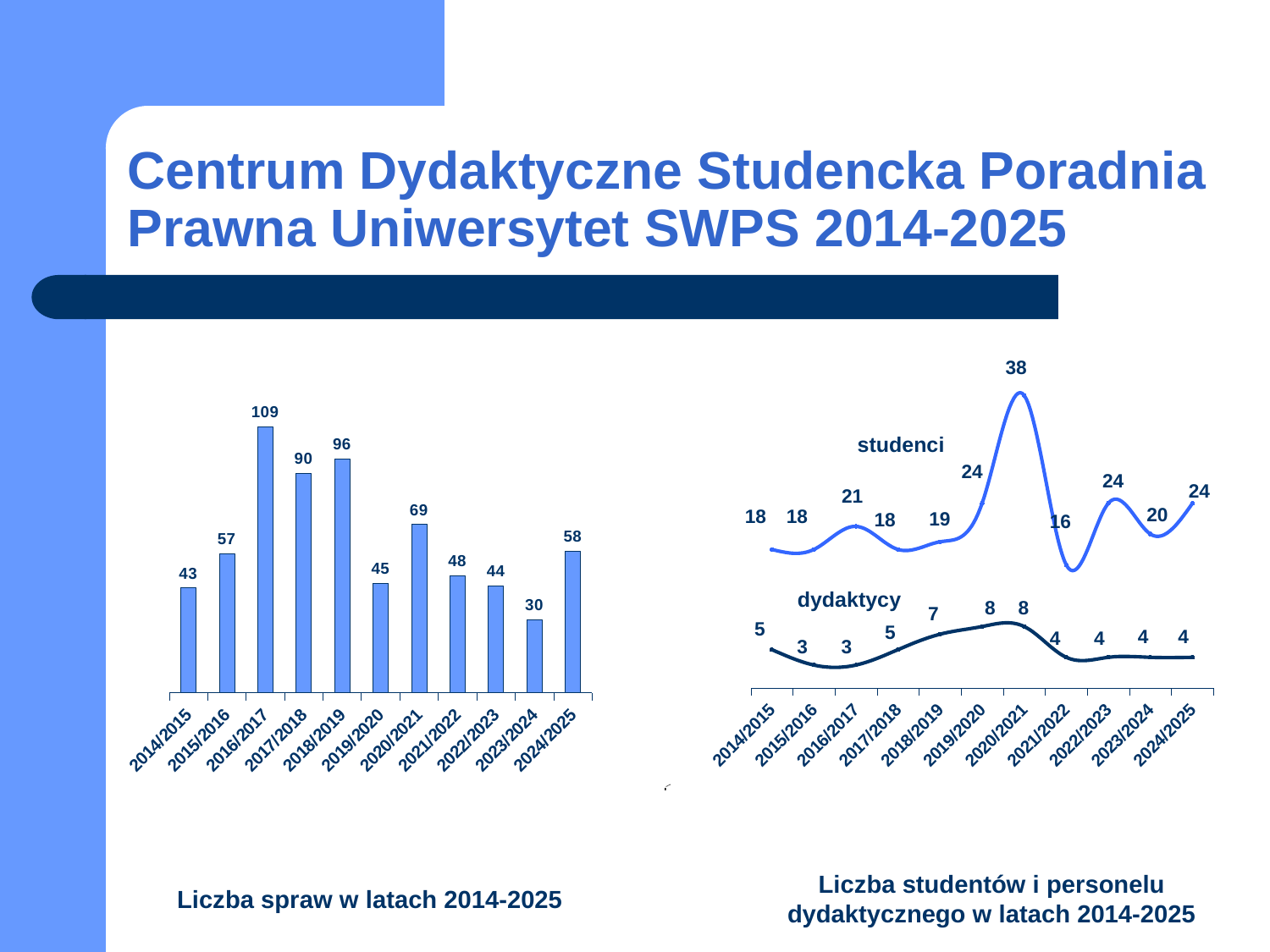
In the right chart (Liczba studentów i personelu dydaktycznego), what is the difference between studenci and dydaktycy in 2024/2025? 20 In the right chart (Liczba studentów i personelu dydaktycznego), what is the value for studenci in 2020/2021? 38 In the right chart (Liczba studentów i personelu dydaktycznego), what is the value for dydaktycy in 2018/2019? 7 In the left chart (Liczba spraw w latach 2014-2025), what is the difference between the values for 2018/2019 and 2017/2018? 6 In the left chart (Liczba spraw w latach 2014-2025), how many years are shown on the x axis? 11 In the right chart (Liczba studentów i personelu dydaktycznego), how many series are plotted? 2 What kind of chart is the left chart (Liczba spraw w latach 2014-2025)? bar chart In the right chart (Liczba studentów i personelu dydaktycznego), which series is higher in 2021/2022, studenci or dydaktycy? studenci What kind of chart is the right chart (Liczba studentów i personelu dydaktycznego)? line chart In the left chart (Liczba spraw w latach 2014-2025), which year has the lowest value? 2023/2024 In the left chart (Liczba spraw w latach 2014-2025), what is the value for 2016/2017? 109 In the left chart (Liczba spraw w latach 2014-2025), which year has the highest value? 2016/2017